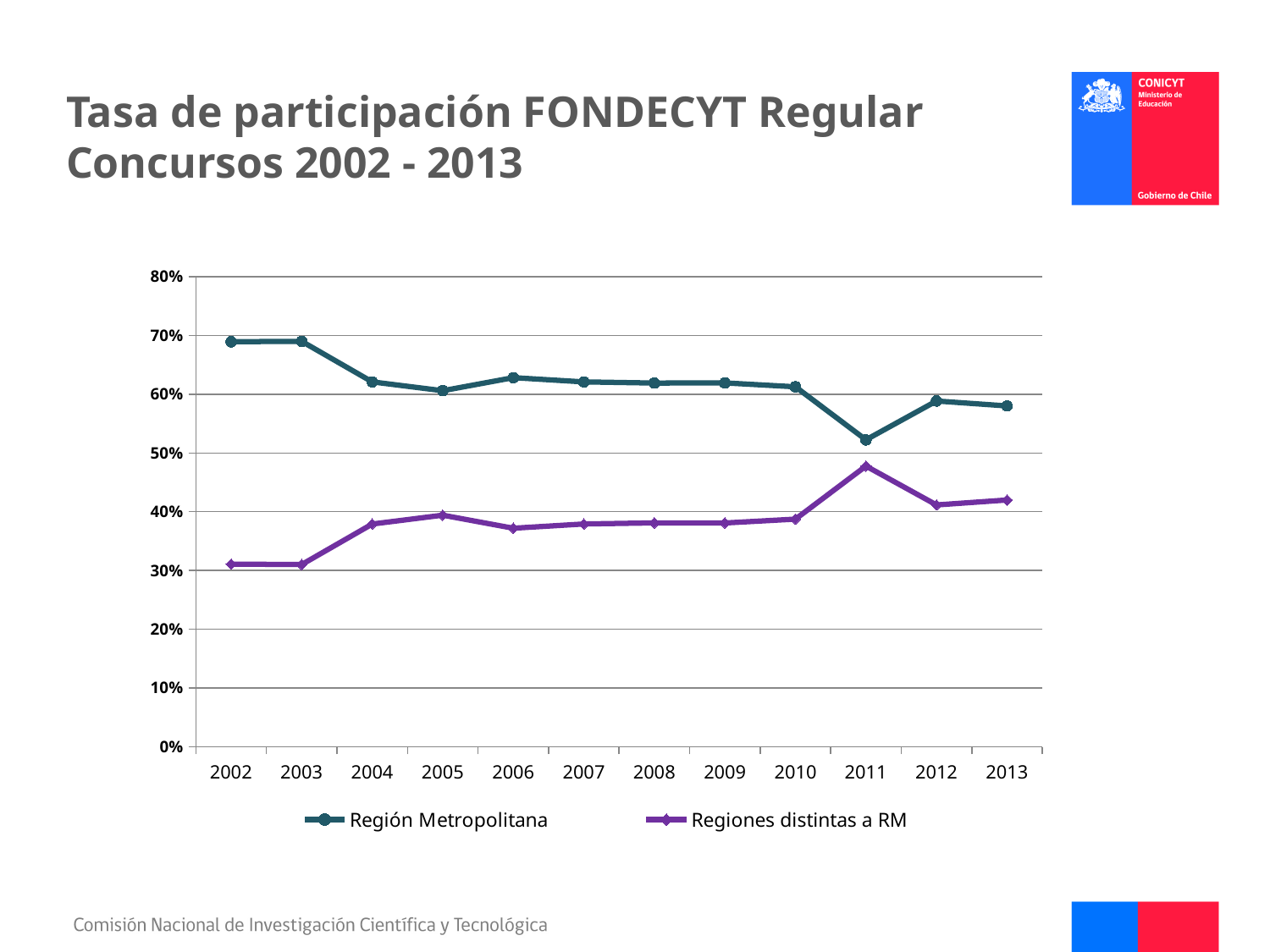
How many years are plotted along the x axis? 12 What is the title of the slide? Tasa de participación FONDECYT Regular Concursos 2002 - 2013 Is the value for Regiones distintas a RM in 2011 greater or less than 40%? greater What kind of chart is shown on the slide? Line chart Overall, does the Región Metropolitana line rise or fall from 2002 to 2013? fall Is the value for Regiones distintas a RM in 2002 greater or less than 40%? less In which year is the value for Regiones distintas a RM highest? 2011 How many series does the legend list? 2 In 2011, which series has the larger value, Región Metropolitana or Regiones distintas a RM? Región Metropolitana Is the value for Región Metropolitana in 2011 greater or less than 60%? less In which year is the value for Región Metropolitana lowest? 2011